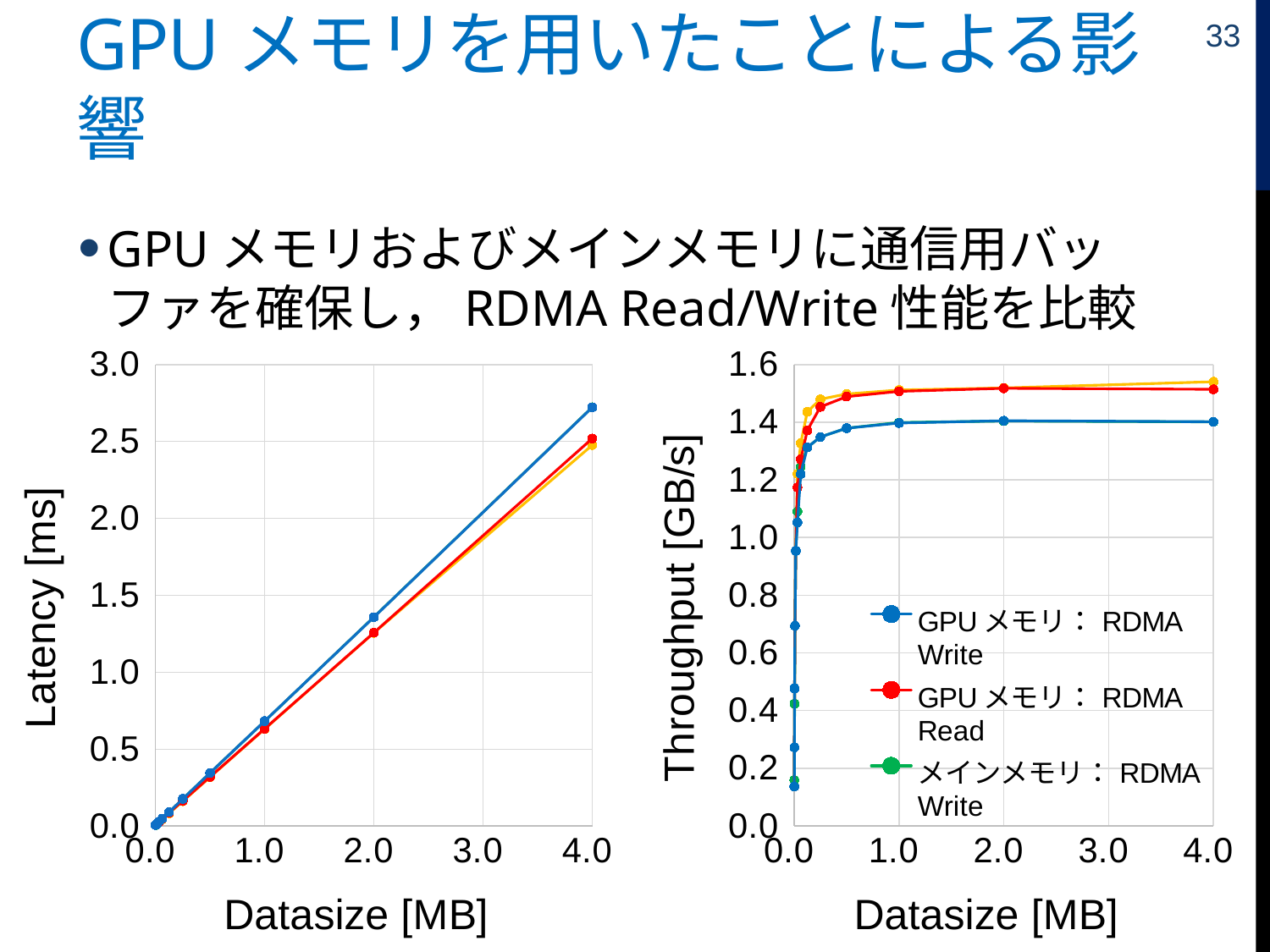
In the left chart, is the latency of the red series (GPU メモリ: RDMA Read) at 4.0 MB greater or less than 3.0? less What kind of chart is the left chart (Latency [ms])? line chart In the left chart, does latency rise or fall as datasize increases? rise In the right chart, is the throughput of GPU メモリ: RDMA Read (red) at 4.0 MB greater or less than 1.4? greater In the left chart, is the latency of the blue series (GPU メモリ: RDMA Write) at 4.0 MB greater or less than 2.5? greater In the right chart, what is the label of the horizontal axis? Datasize [MB] In the left chart, what is the label of the vertical axis? Latency [ms] What kind of chart is the right chart (Throughput [GB/s])? line chart In the right chart, how many series does the legend list? 3 In the left chart, at 4.0 MB, which series has the higher latency: GPU メモリ: RDMA Write (blue) or GPU メモリ: RDMA Read (red)? GPU メモリ: RDMA Write In the right chart, at 4.0 MB, which series has the higher throughput: GPU メモリ: RDMA Write (blue) or GPU メモリ: RDMA Read (red)? GPU メモリ: RDMA Read